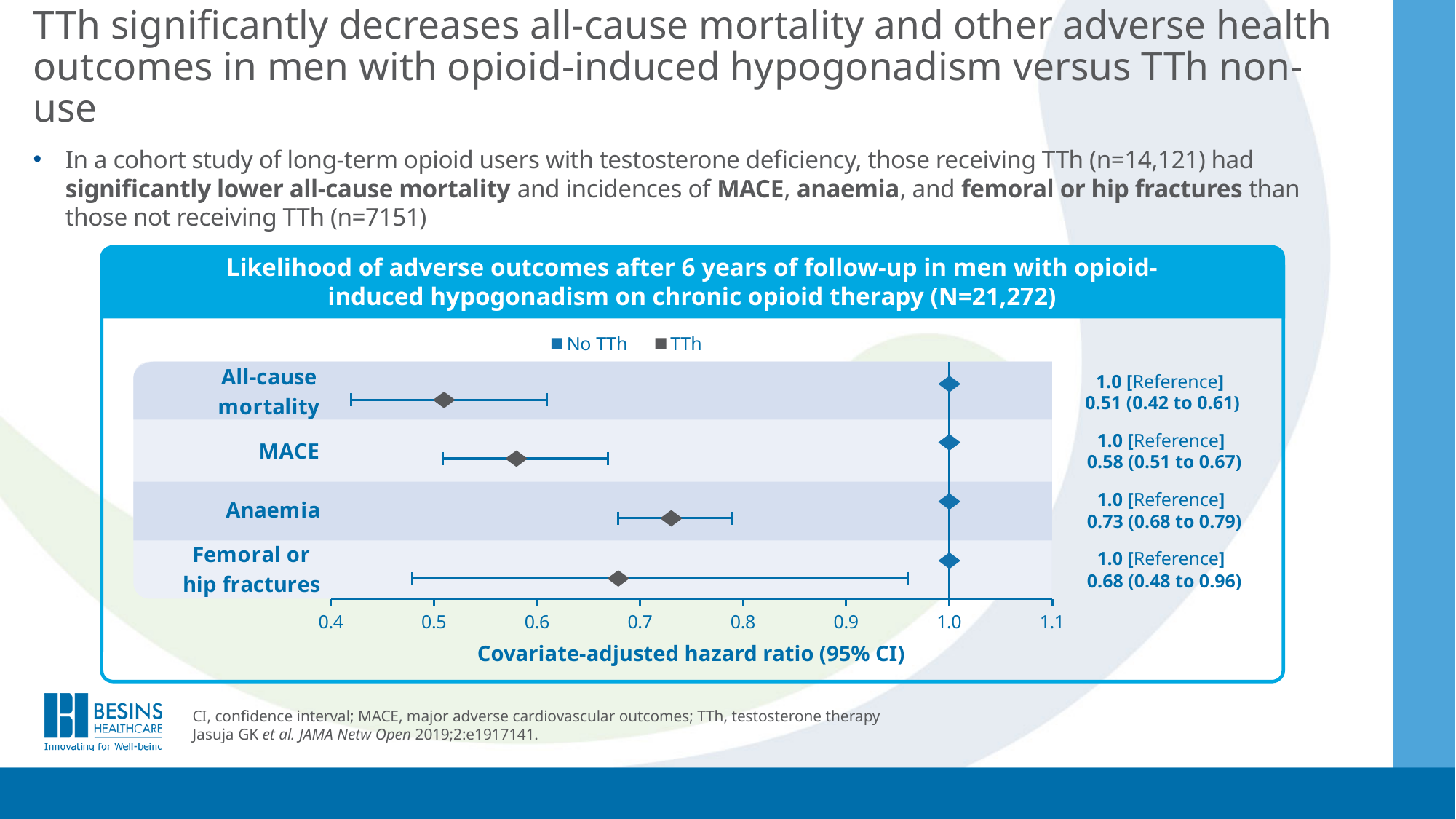
Which outcome has the lowest hazard ratio in the TTh group? All-cause mortality What is the hazard ratio for MACE in the TTh group? 0.58 What is the covariate-adjusted hazard ratio for all-cause mortality in the TTh group? 0.51 Which outcome has the highest hazard ratio in the TTh group? Anaemia How many outcomes are plotted in the chart? 4 Is the TTh hazard ratio for anaemia greater or less than 0.7? greater Which has a larger TTh hazard ratio, MACE or femoral or hip fractures? Femoral or hip fractures What is the hazard ratio and 95% CI for femoral or hip fractures in the TTh group? 0.68 (0.48 to 0.96) What is the x-axis label of the chart? Covariate-adjusted hazard ratio (95% CI) How many series does the legend list? 2 What is the difference between the TTh hazard ratios for anaemia and all-cause mortality? 0.22 What is the 95% CI for anaemia in the TTh group? 0.68 to 0.79